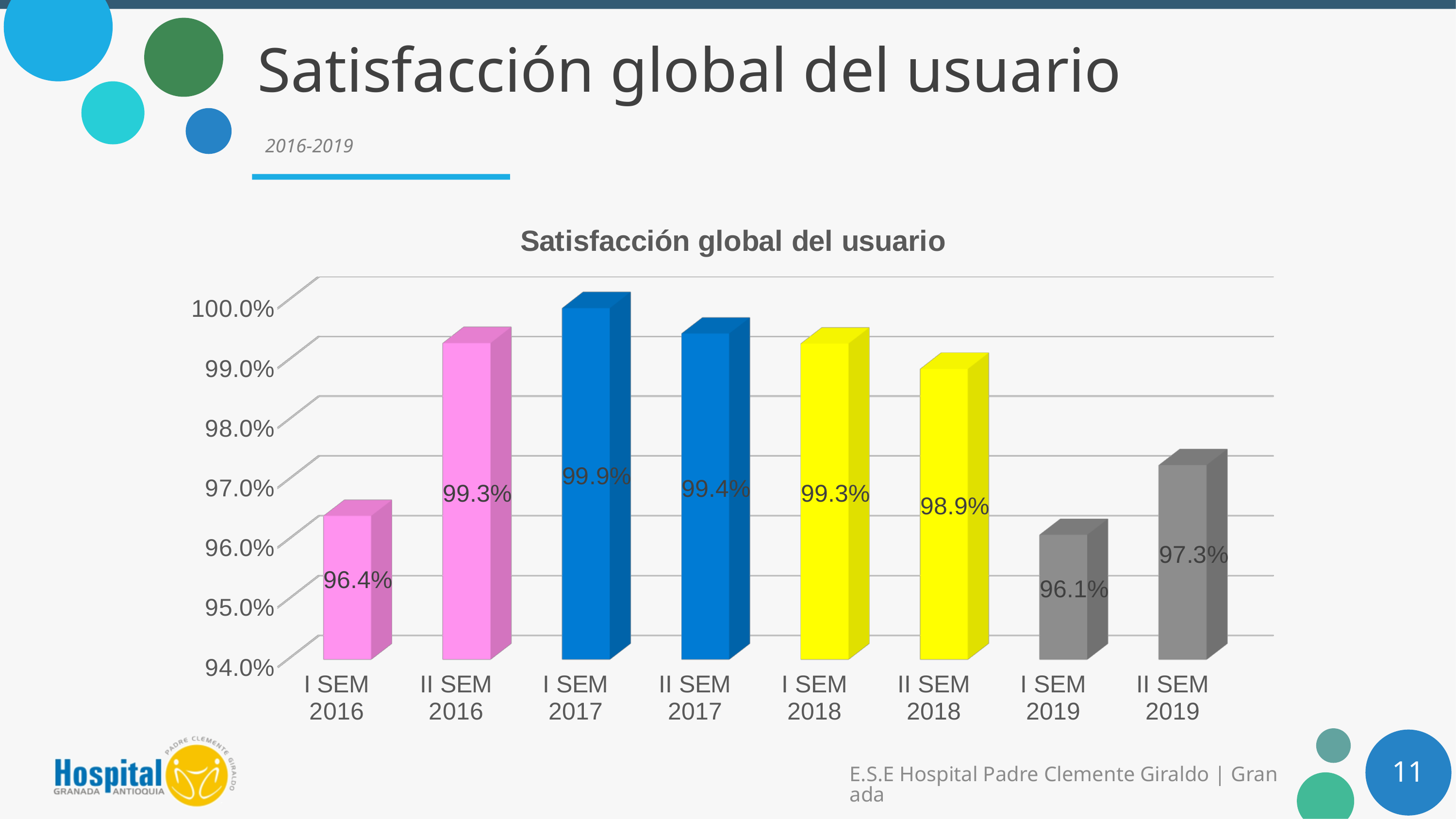
Do the values rise or fall from II SEM 2017 to I SEM 2019? fall What is the value for II SEM 2017? 99.4% Which category has the highest value? I SEM 2017 Is the value for II SEM 2016 greater or less than 98.0%? greater What is the difference between the values for I SEM 2017 and I SEM 2019? 3.8% What is the value for I SEM 2016? 96.4% Which is larger, the value for II SEM 2018 or the value for II SEM 2019? II SEM 2018 Which category has the lowest value? I SEM 2019 What is the title of the chart? Satisfacción global del usuario What is the value for II SEM 2019? 97.3% How many categories are shown on the x axis? 8 What kind of chart is shown on the slide? bar chart